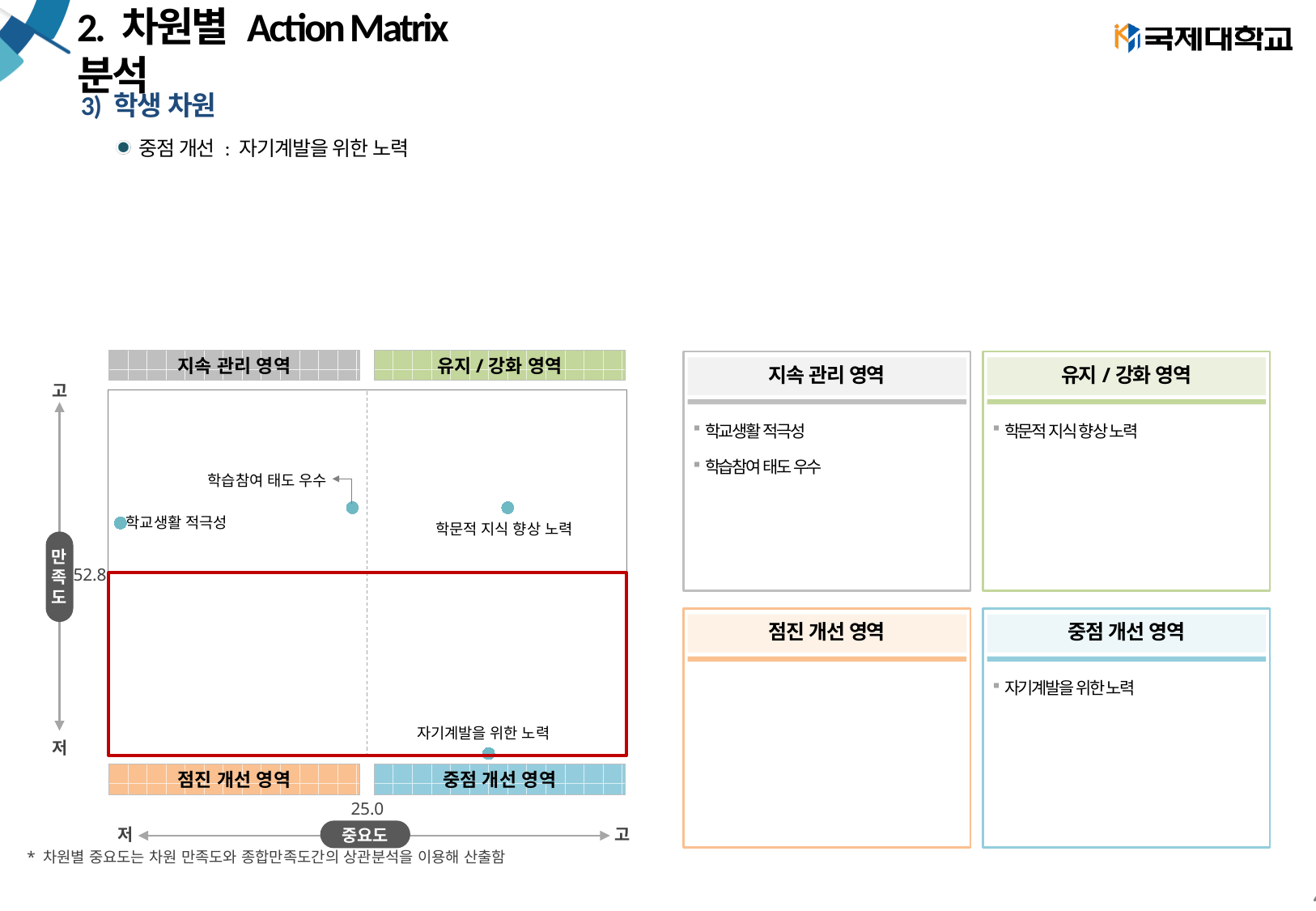
Which item falls in the 중점 개선 영역 quadrant of the matrix? 자기계발을 위한 노력 Which item has the lowest 만족도 (satisfaction) on the matrix? 자기계발을 위한 노력 Is the 중요도 value for 자기계발을 위한 노력 greater or less than 25.0? greater Which has the higher 중요도: 학습참여 태도 우수 or 학문적 지식 향상 노력? 학문적 지식 향상 노력 Which item has the lowest 중요도 (importance) on the matrix? 학교생활 적극성 Is the 만족도 value for 학교생활 적극성 greater or less than 52.8? greater What is the label of the vertical axis of the matrix? 만족도 Which item has the highest 중요도 (importance) on the matrix? 학문적 지식 향상 노력 What kind of chart is shown on the slide? scatter chart How many data points are plotted on the action matrix? 4 Is the 중요도 value for 학교생활 적극성 greater or less than 25.0? less Which has the higher 만족도: 학교생활 적극성 or 자기계발을 위한 노력? 학교생활 적극성